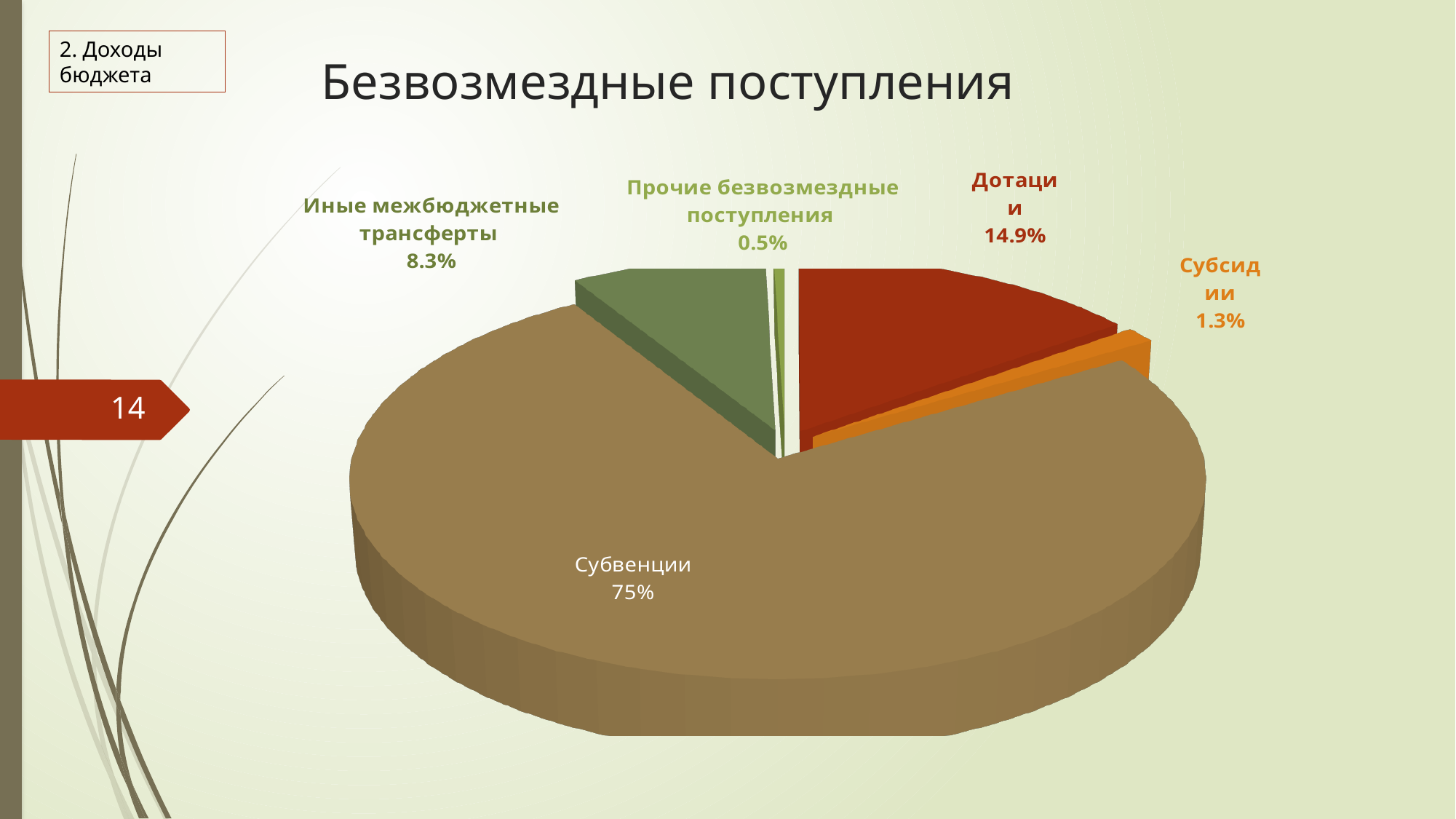
What is the value shown for Иные межбюджетные трансферты? 8.3% What is the value shown for Субсидии? 1.3% Which category has the largest slice of the pie? Субвенции What is the title of the chart? Безвозмездные поступления Which is larger, the value for Субсидии or the value for Прочие безвозмездные поступления? Субсидии How many categories are shown in the pie chart? 5 Which category has the smallest slice of the pie? Прочие безвозмездные поступления What is the value shown for Прочие безвозмездные поступления? 0.5% What is the difference between the values for Дотации and Иные межбюджетные трансферты? 6.6% What is the value shown for Дотации? 14.9% What kind of chart is shown on the slide? Pie chart What share of the pie does Субвенции hold? 75%